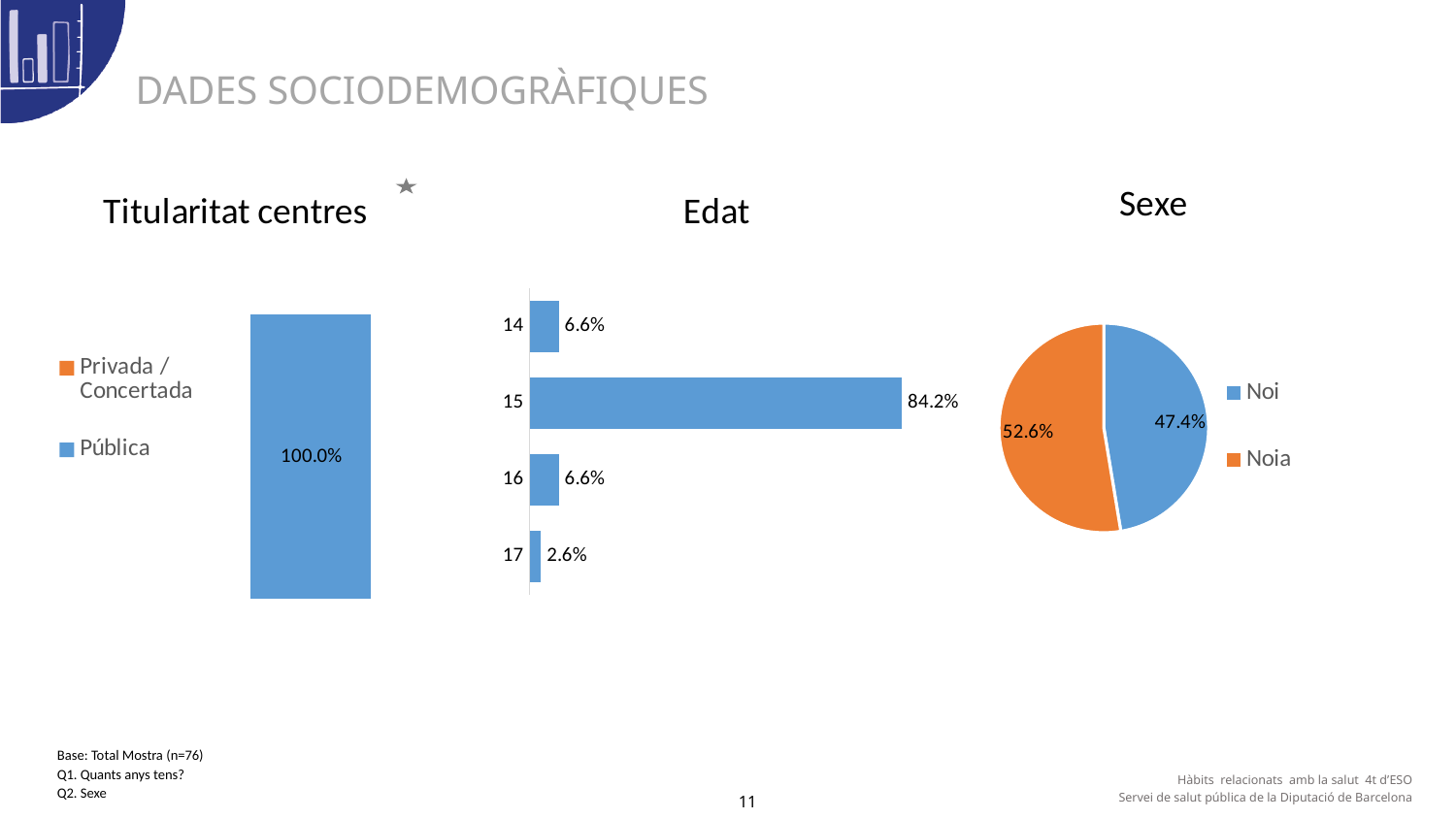
In the 'Edat' chart, what is the value for age 15? 84.2% In the 'Edat' chart, which age has the highest value? 15 In the 'Edat' chart, how many age categories are shown? 4 What kind of chart is the 'Edat' chart? bar chart In the 'Edat' chart, what is the value for age 17? 2.6% In the 'Sexe' chart, which is larger, 'Noi' or 'Noia'? Noia In the 'Edat' chart, what is the difference between the values for age 15 and age 14? 77.6% What kind of chart is the 'Sexe' chart? pie chart In the 'Titularitat centres' chart, what is the value for 'Pública'? 100.0% In the 'Sexe' chart, what share does 'Noia' have? 52.6% In the 'Edat' chart, which age has the lowest value? 17 In the 'Sexe' chart, what is the value for 'Noi'? 47.4%